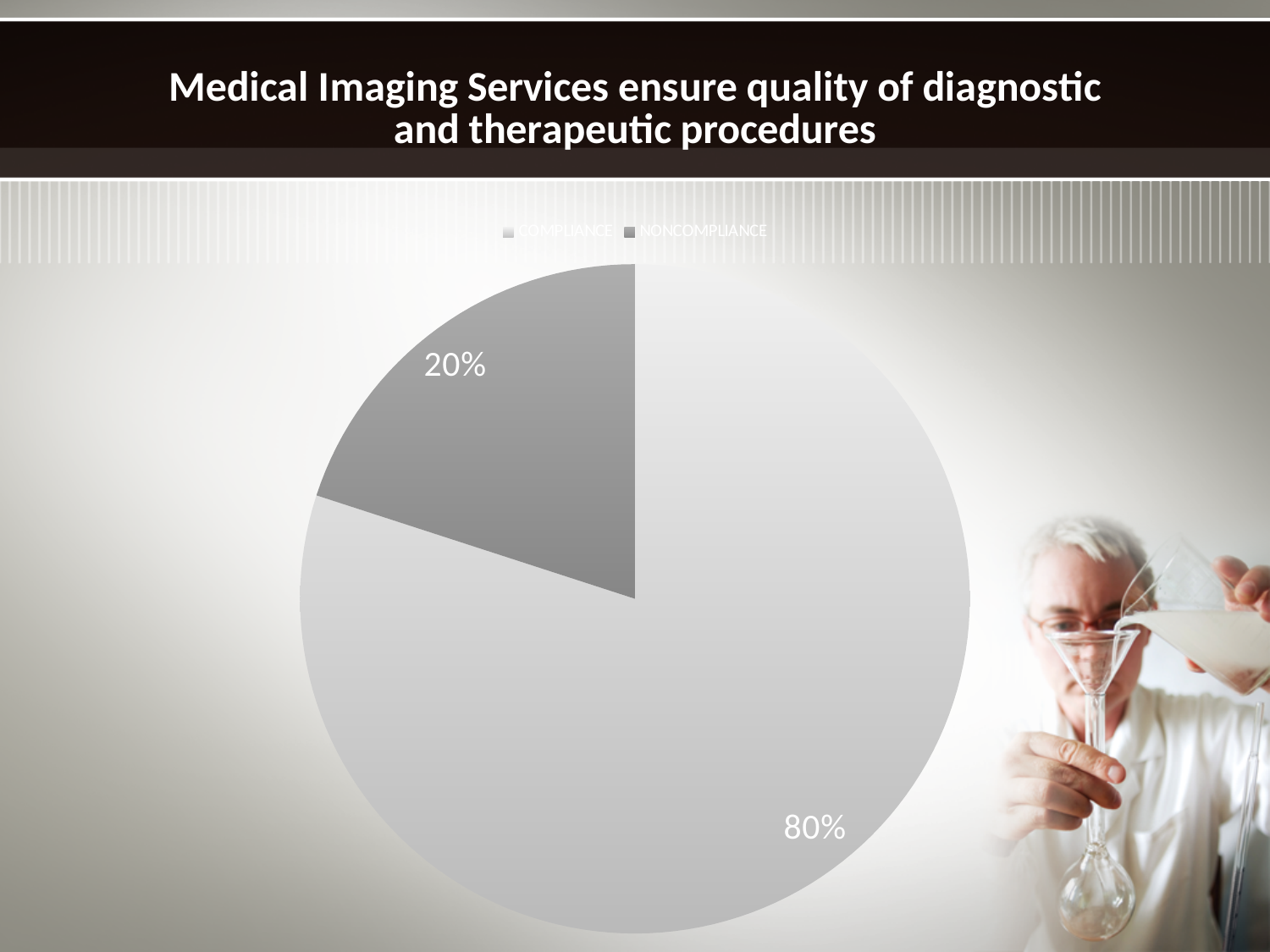
Which is larger, the COMPLIANCE slice or the NONCOMPLIANCE slice? COMPLIANCE Which slice is the largest in the pie chart? COMPLIANCE What share of the pie does COMPLIANCE take? 80% How many entries does the legend list? 2 What is the difference in percentage points between the COMPLIANCE and NONCOMPLIANCE slices? 60% What kind of chart is shown on the slide? pie chart What share of the pie does NONCOMPLIANCE take? 20% What is the title shown above the pie chart on the slide? Medical Imaging Services ensure quality of diagnostic and therapeutic procedures Which slice is the smallest in the pie chart? NONCOMPLIANCE What are the two legend entries of the pie chart? COMPLIANCE and NONCOMPLIANCE How many slices does the pie chart have? 2